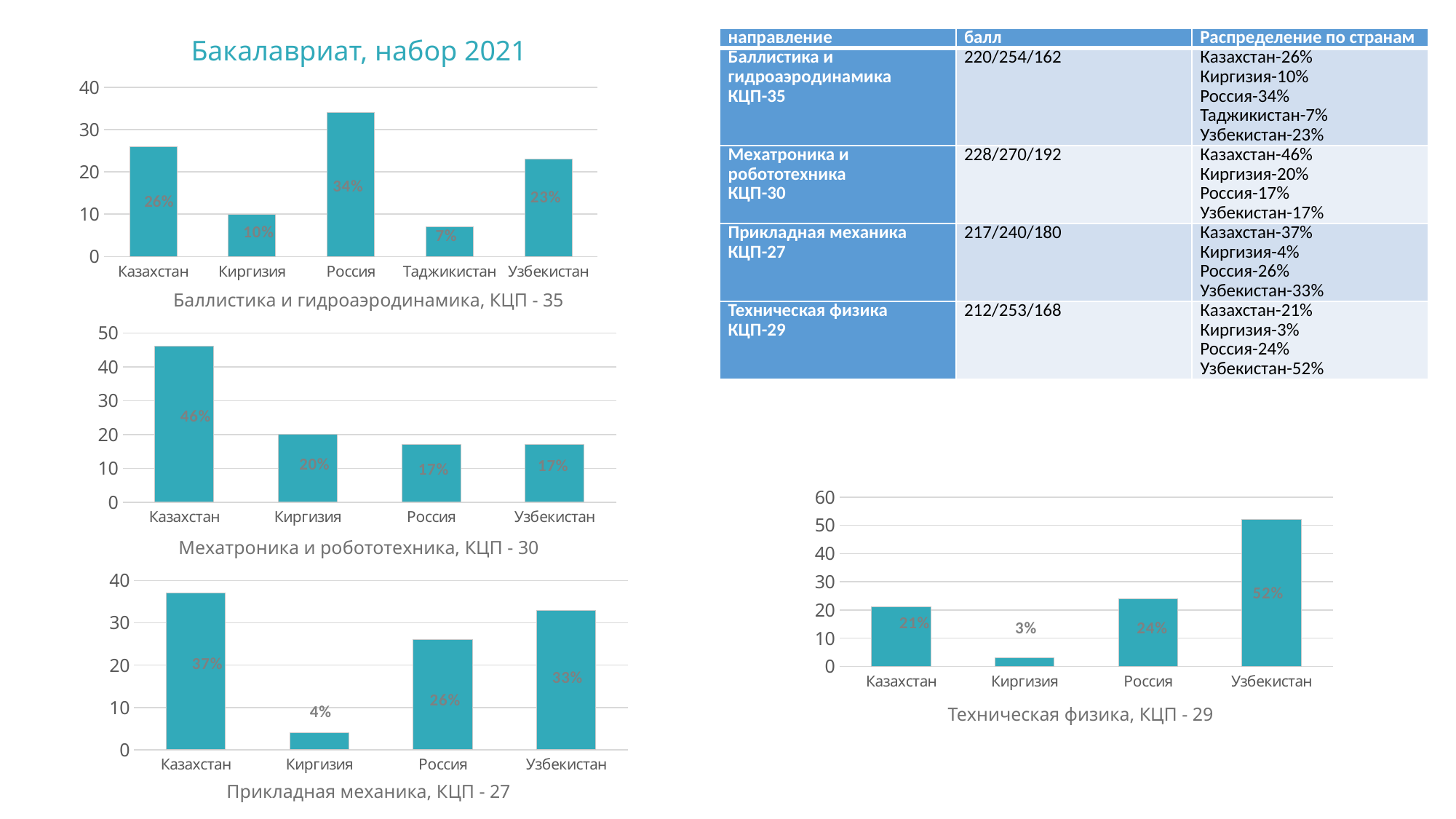
In the chart titled "Техническая физика, КЦП - 29", what is the value for Узбекистан? 52% In the chart titled "Мехатроника и робототехника, КЦП - 30", what is the value for Казахстан? 46% In the chart titled "Прикладная механика, КЦП - 27", which is larger, the value for Россия or the value for Узбекистан? Узбекистан In the chart titled "Прикладная механика, КЦП - 27", what is the value for Киргизия? 4% What is the main title shown above the charts on the left side of the slide? Бакалавриат, набор 2021 How many categories are shown in the chart titled "Баллистика и гидроаэродинамика, КЦП - 35"? 5 In the chart titled "Прикладная механика, КЦП - 27", which category has the highest value? Казахстан In the chart titled "Техническая физика, КЦП - 29", is the value for Узбекистан greater or less than 40? greater What kind of chart is the chart titled "Техническая физика, КЦП - 29"? bar chart In the chart titled "Баллистика и гидроаэродинамика, КЦП - 35", which category has the lowest value? Таджикистан In the chart titled "Мехатроника и робототехника, КЦП - 30", what is the difference between the values for Казахстан and Киргизия? 26% In the chart titled "Баллистика и гидроаэродинамика, КЦП - 35", what is the value for Россия? 34%